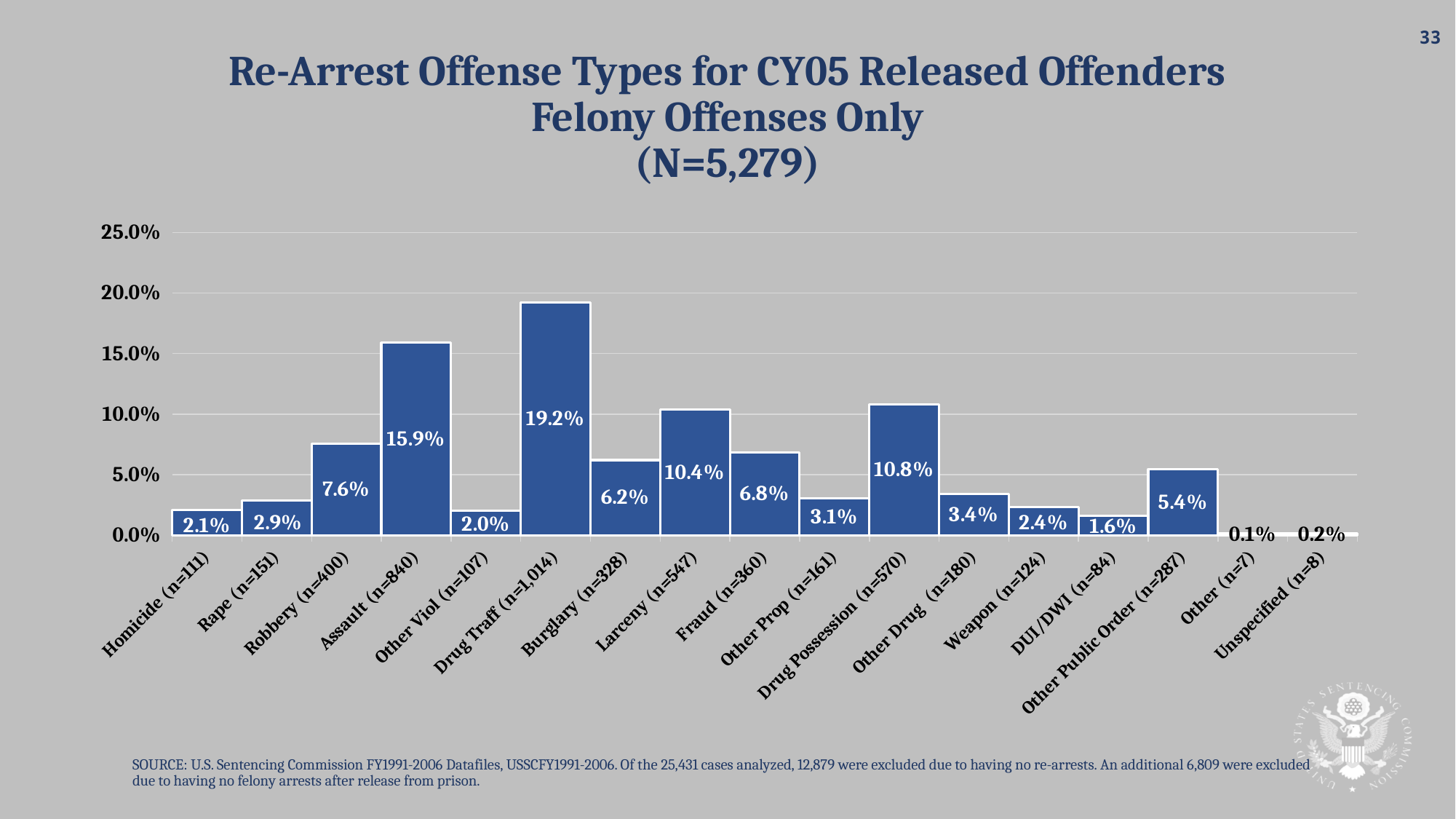
Which offense type has the highest re-arrest percentage? Drug Traff (n=1,014) What is the difference between the values for Assault (n=840) and Robbery (n=400)? 8.3% What is the value for Drug Traff (n=1,014)? 19.2% Is the value for Assault (n=840) greater or less than 15.0%? greater What kind of chart is shown on the slide? Bar chart Which offense type has the lowest re-arrest percentage? Other (n=7) What is the N value given in the chart title? 5,279 What is the total of the values for Other (n=7) and Unspecified (n=8)? 0.3% How many offense type categories are shown on the x axis? 17 Which is larger, the value for Drug Possession (n=570) or the value for Larceny (n=547)? Drug Possession (n=570) What is the value for DUI/DWI (n=84)? 1.6% What is the value for Larceny (n=547)? 10.4%